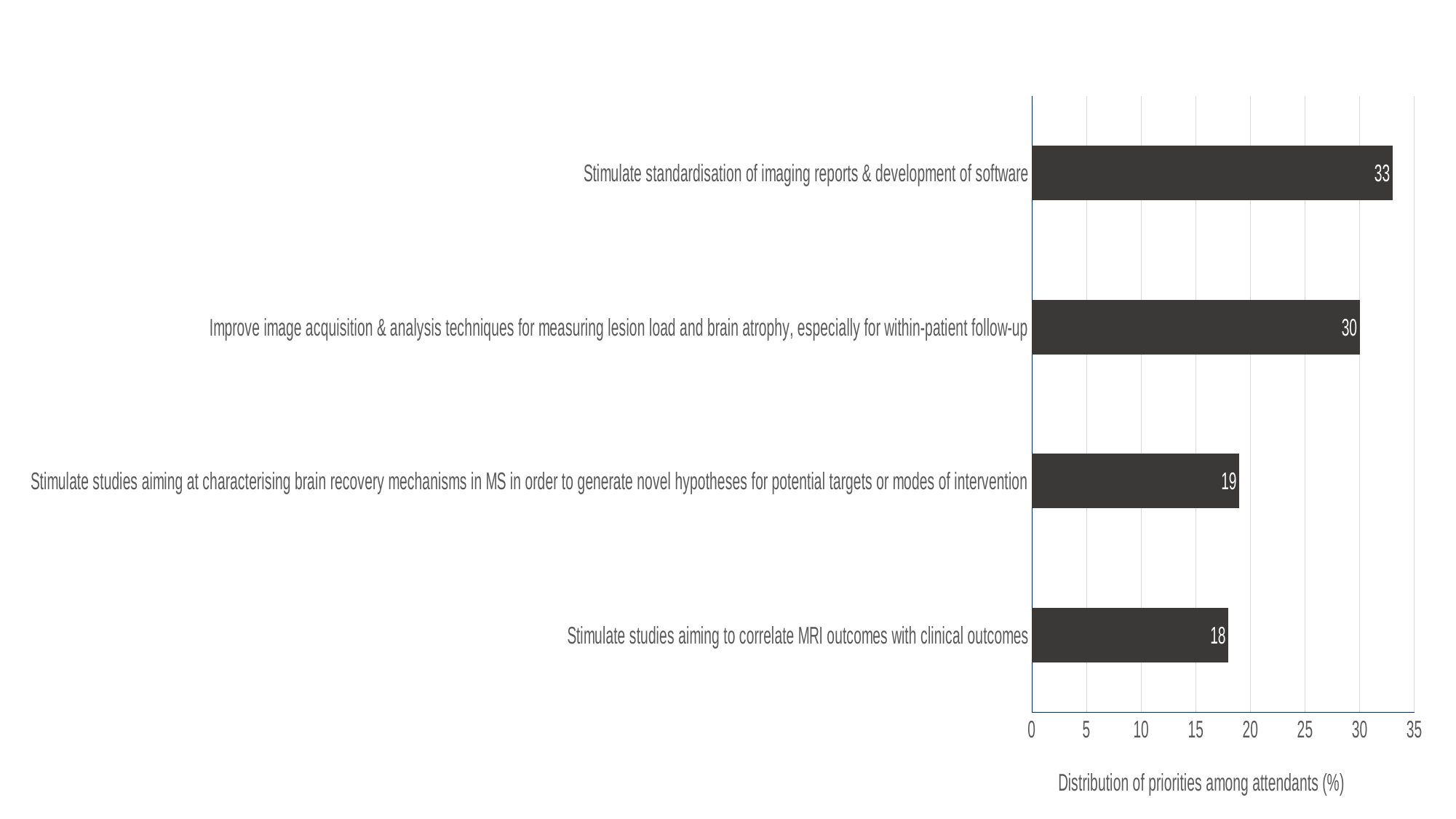
What is the difference between the values for 'Stimulate standardisation of imaging reports & development of software' and 'Improve image acquisition & analysis techniques for measuring lesion load and brain atrophy, especially for within-patient follow-up'? 3 What is the label of the horizontal axis? Distribution of priorities among attendants (%) What is the value for 'Improve image acquisition & analysis techniques for measuring lesion load and brain atrophy, especially for within-patient follow-up'? 30 What is the value for 'Stimulate studies aiming to correlate MRI outcomes with clinical outcomes'? 18 How many categories are shown in the chart? 4 What kind of chart is shown on the slide? bar chart Which category has the highest value? Stimulate standardisation of imaging reports & development of software What is the value for 'Stimulate studies aiming at characterising brain recovery mechanisms in MS in order to generate novel hypotheses for potential targets or modes of intervention'? 19 What is the value for 'Stimulate standardisation of imaging reports & development of software'? 33 Which is larger: the value for 'Improve image acquisition & analysis techniques for measuring lesion load and brain atrophy, especially for within-patient follow-up' or the value for 'Stimulate studies aiming to correlate MRI outcomes with clinical outcomes'? Improve image acquisition & analysis techniques for measuring lesion load and brain atrophy, especially for within-patient follow-up Which category has the lowest value? Stimulate studies aiming to correlate MRI outcomes with clinical outcomes Is the value for 'Stimulate standardisation of imaging reports & development of software' greater or less than 30? greater